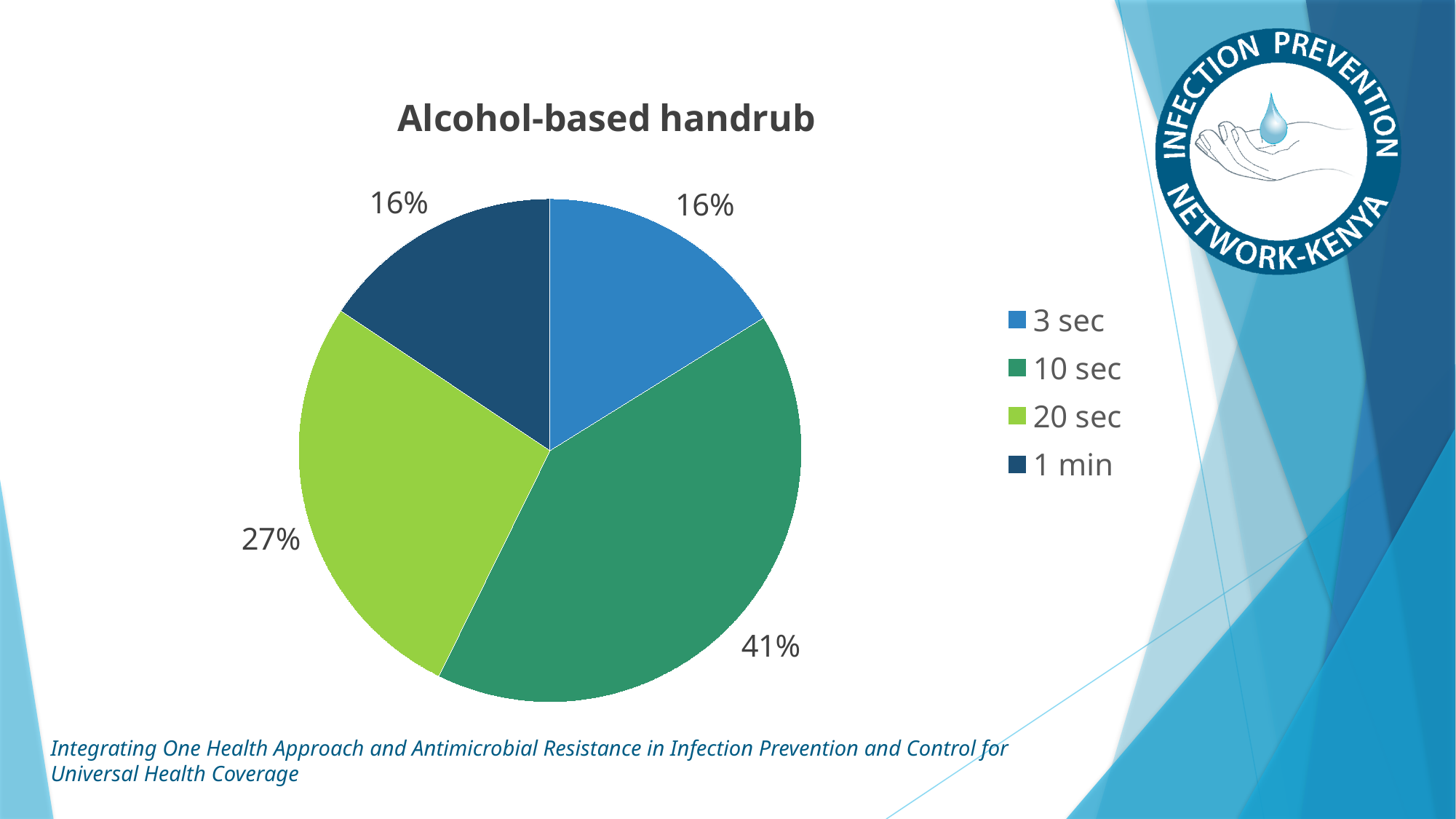
Which colour represents the 20 sec category in the legend? light green What share of the pie does the 10 sec slice represent? 41% What kind of chart is shown on the slide? pie chart What share of the pie does the 20 sec slice represent? 27% Which is larger, the 20 sec slice or the 3 sec slice? 20 sec What is the difference between the 10 sec share and the 20 sec share? 14% What is the value shown for the 1 min slice? 16% What is the value shown for the 3 sec slice? 16% What is the title of the chart? Alcohol-based handrub How many categories does the legend list? 4 Which category has the largest slice of the pie? 10 sec What is the difference between the 20 sec share and the 1 min share? 11%